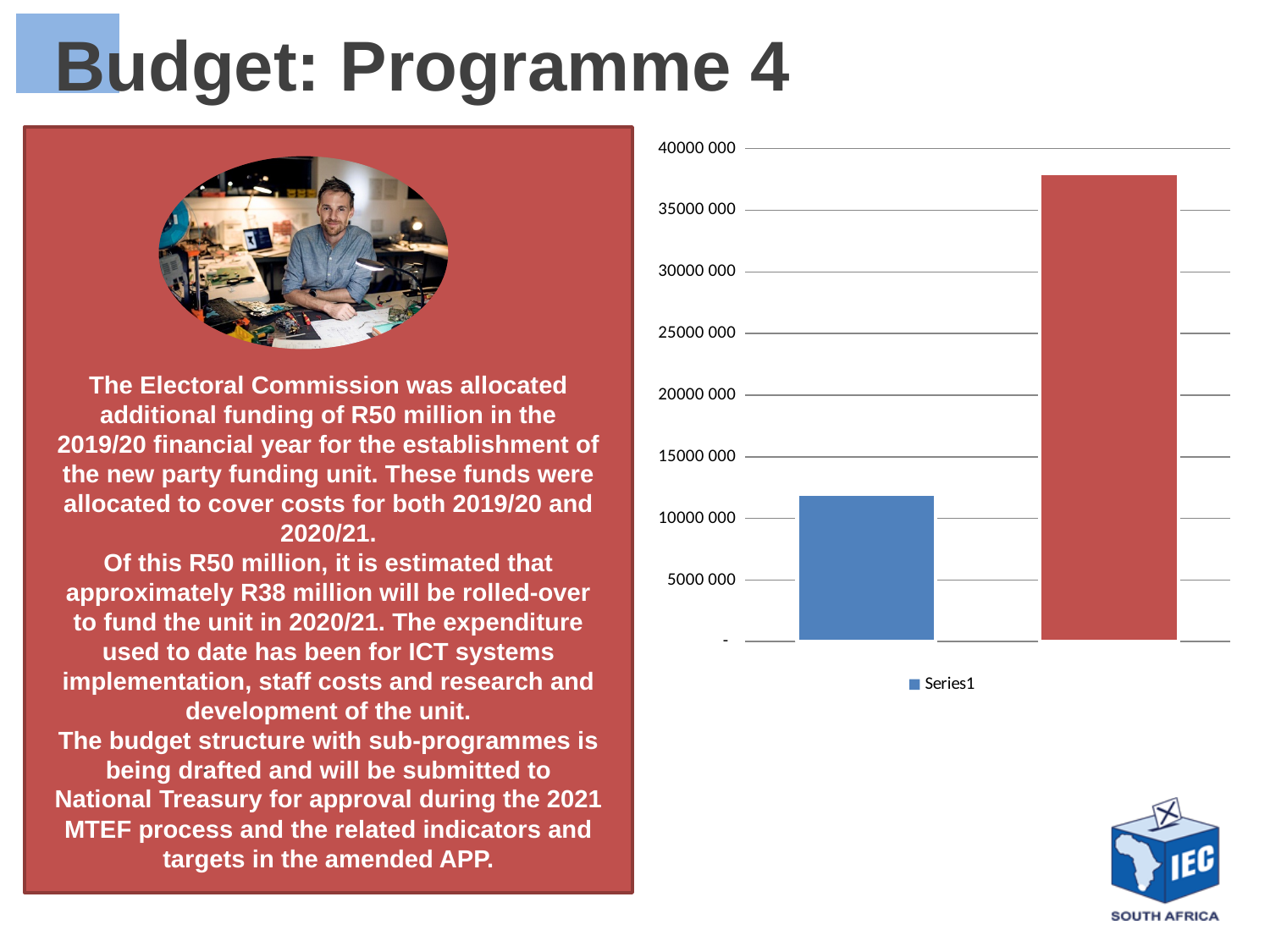
Which bar is taller, the left (blue) bar or the right (red) bar? the right (red) bar How many bars are plotted in the chart? 2 What kind of chart is shown on the right of the slide? bar chart How many series does the chart legend list? 1 What is the name of the series shown in the chart legend? Series1 Is the value of the left (blue) bar greater or less than 10000 000? greater What is the highest value shown on the chart's vertical axis? 40000 000 Is the value of the right (red) bar greater or less than 40000 000? less Is the value of the left (blue) bar greater or less than 15000 000? less Do the bar values rise or fall from left to right across the chart? rise